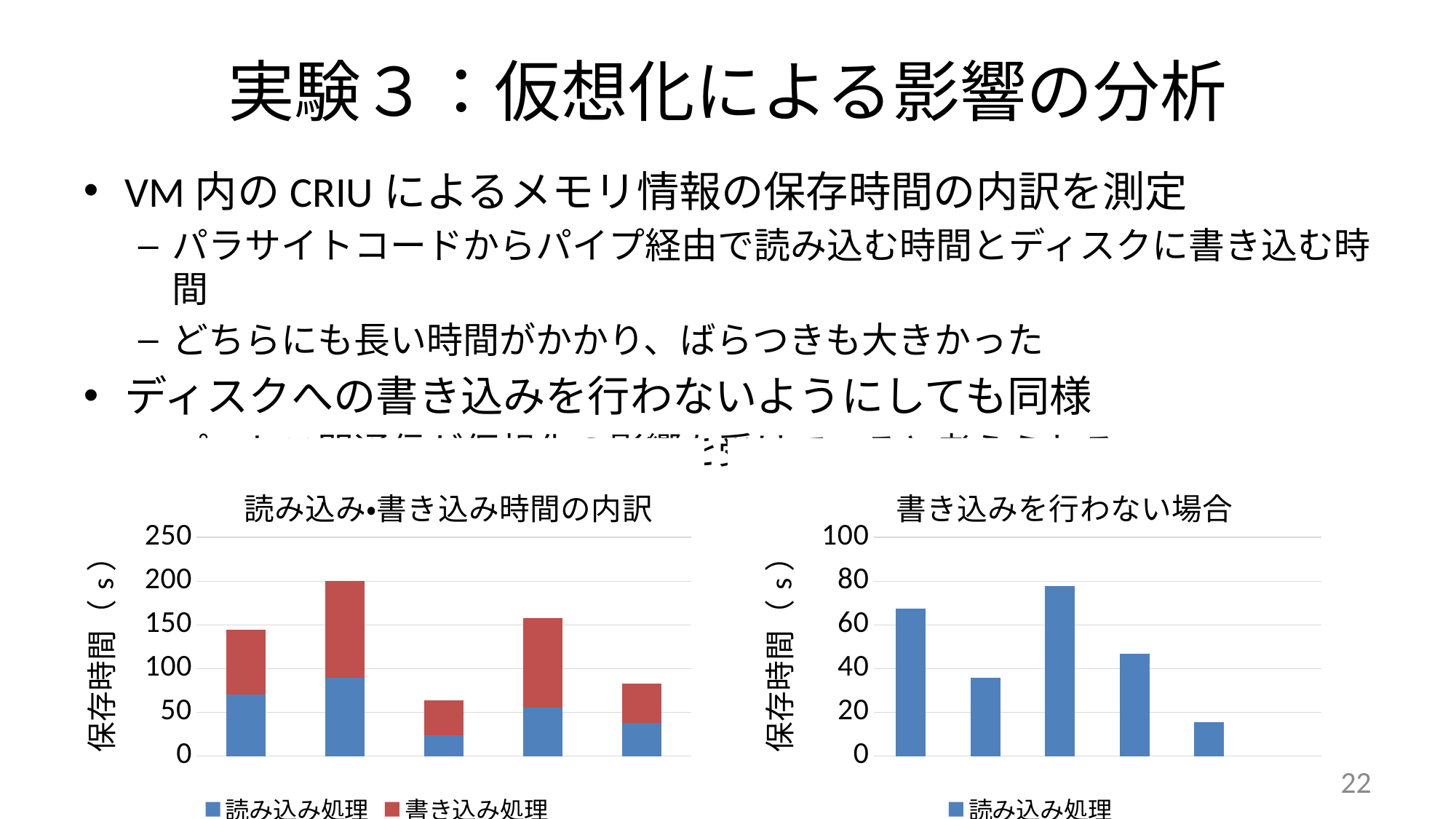
What kind of chart is the chart titled 読み込み•書き込み時間の内訳 on the left? stacked bar chart In the chart titled 読み込み•書き込み時間の内訳, is the total of the first bar greater or less than 100? greater What kind of chart is the chart titled 書き込みを行わない場合 on the right? bar chart In the chart titled 読み込み•書き込み時間の内訳, how many series does the legend list? 2 In the chart titled 読み込み•書き込み時間の内訳, which bar (by position from the left) has the highest total? the second bar In the chart titled 読み込み•書き込み時間の内訳, which series is shown in red? 書き込み処理 In the chart titled 読み込み•書き込み時間の内訳, which bar (by position from the left) has the lowest total? the third bar In the chart titled 書き込みを行わない場合, is the value of the fifth bar greater or less than 20? less In the chart titled 読み込み•書き込み時間の内訳, is the total of the third bar greater or less than 100? less In the chart titled 読み込み•書き込み時間の内訳, how many stacked bars are plotted? 5 In the chart titled 書き込みを行わない場合, which bar (by position from the left) is the highest? the third bar In the chart titled 書き込みを行わない場合, how many bars are plotted? 5